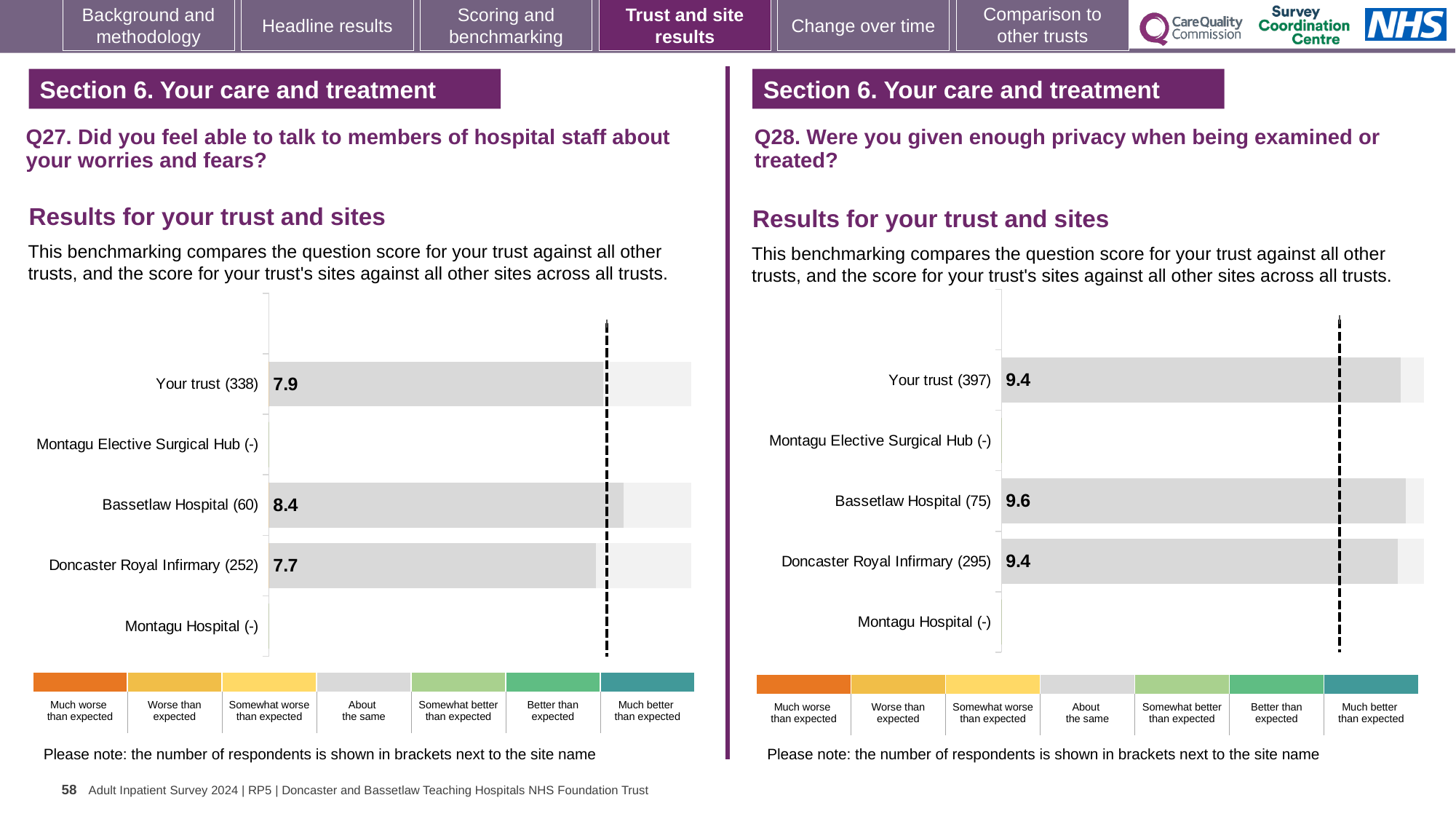
What kind of chart is used in the Q28 chart on the right? Bar chart In the Q27 chart on the left, what is the score for Bassetlaw Hospital (60)? 8.4 In the Q27 chart on the left, which site with a printed score has the highest value? Bassetlaw Hospital (60) In the Q27 chart on the left, what is the score for Your trust (338)? 7.9 In the Q28 chart on the right, what is the score for Bassetlaw Hospital (75)? 9.6 In the Q28 chart on the right, what is the score for Doncaster Royal Infirmary (295)? 9.4 In the Q27 chart on the left, how many categories does the colour key below the chart list? 7 In the Q27 chart on the left, what is the score for Doncaster Royal Infirmary (252)? 7.7 In the Q27 chart on the left, what is the difference between the scores for Bassetlaw Hospital (60) and Doncaster Royal Infirmary (252)? 0.7 In the Q28 chart on the right, which is larger: the score for Bassetlaw Hospital (75) or Doncaster Royal Infirmary (295)? Bassetlaw Hospital (75) In the Q27 chart on the left, how many site/trust categories are listed on the vertical axis? 5 In the Q28 chart on the right, what is the score for Your trust (397)? 9.4